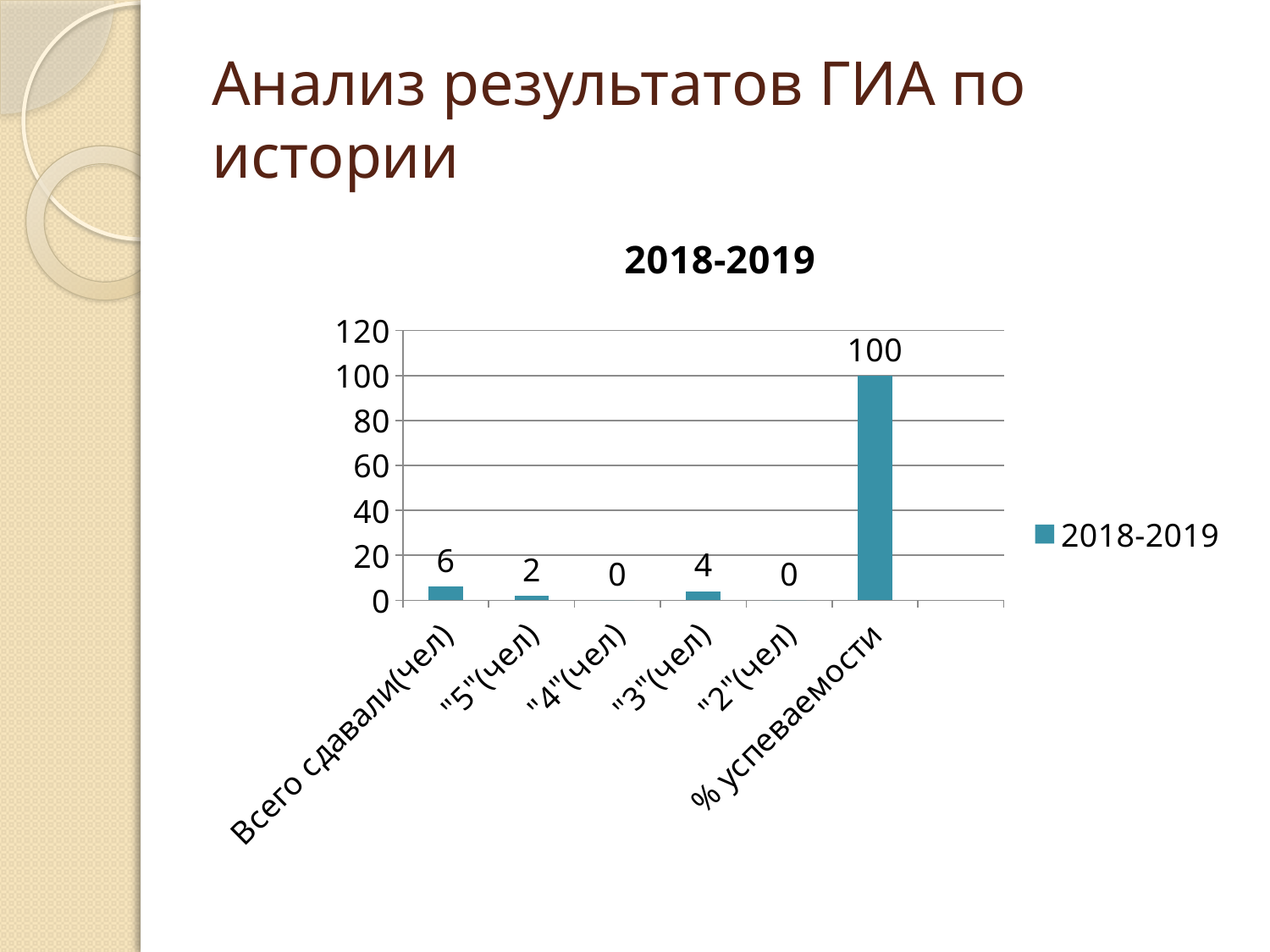
How many series does the legend list? 1 Which is larger, the value for "5"(чел) or the value for "3"(чел)? "3"(чел) What is the difference between the values for "3"(чел) and "5"(чел)? 2 What is the value for "% успеваемости"? 100 What is the value for "3"(чел)? 4 What is the value for "5"(чел)? 2 Which category has the highest value? % успеваемости How many categories are shown on the x axis? 6 What kind of chart is shown on the slide? bar chart What is the title of the chart? 2018-2019 What is the value for "Всего сдавали(чел)"? 6 Is the value for "% успеваемости" greater or less than 80? greater